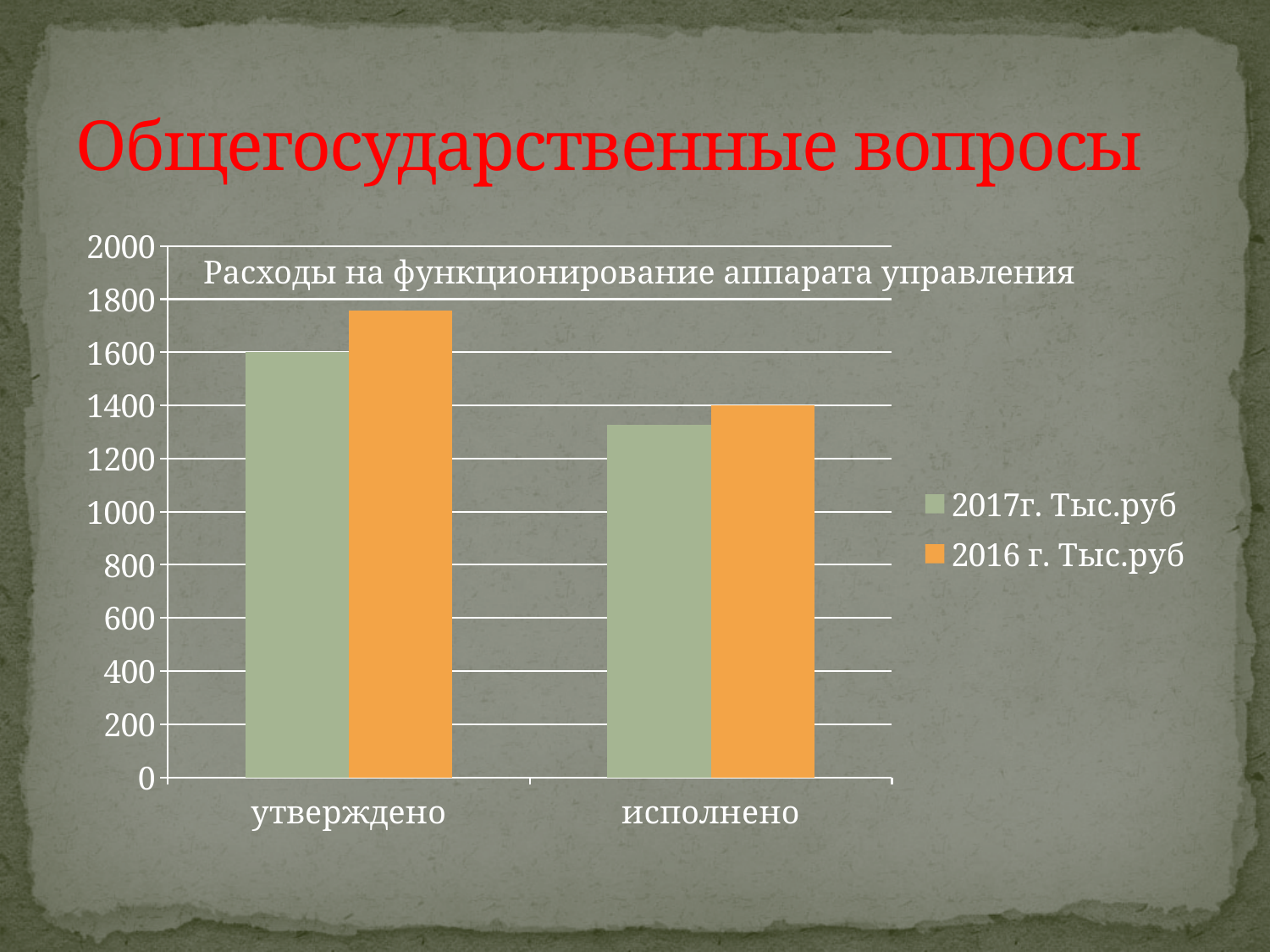
Is the value for 2017г. Тыс.руб in the исполнено category greater or less than 1200? greater What kind of chart is shown on the slide? bar chart How many series does the legend list? 2 Which series is shown in orange? 2016 г. Тыс.руб Is the value for 2016 г. Тыс.руб in the утверждено category greater or less than 1800? less Is the value for 2017г. Тыс.руб in the исполнено category greater or less than 1400? less In the утверждено category, which series has the larger value, 2017г. Тыс.руб or 2016 г. Тыс.руб? 2016 г. Тыс.руб How many categories are shown on the x axis? 2 Which bar on the chart is the lowest overall? 2017г. Тыс.руб, исполнено For the 2017г. Тыс.руб series, which category has the higher value? утверждено What is the title of the chart? Расходы на функционирование аппарата управления